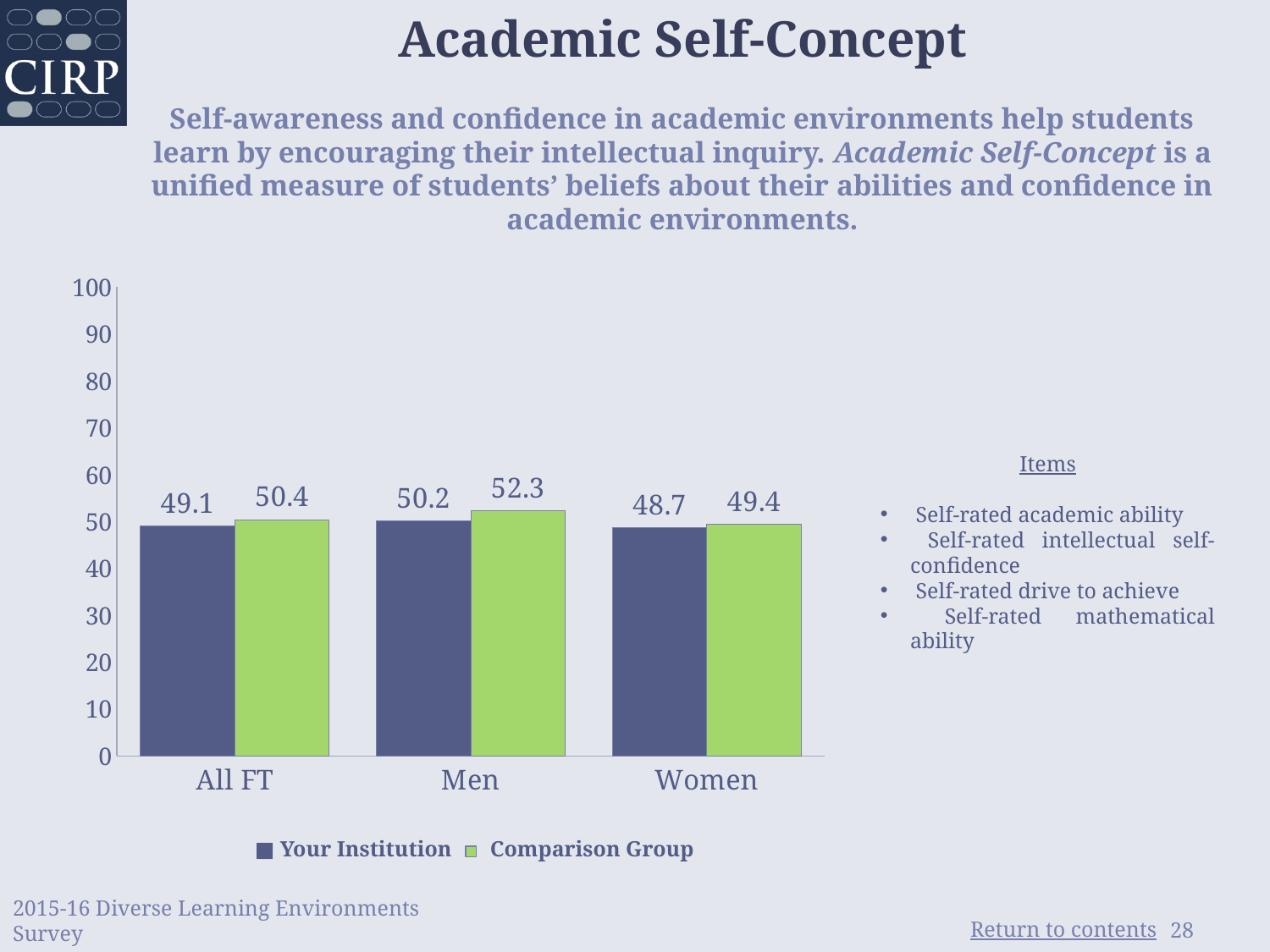
Which is larger for Women: Your Institution or Comparison Group? Comparison Group How many series does the legend list? 2 What is the difference between the Comparison Group and Your Institution values for Men? 2.1 What is the difference between the Comparison Group and Your Institution values for All FT? 1.3 Which category has the lowest Your Institution value? Women Which category has the highest Comparison Group value? Men What is the value for Your Institution in the All FT category? 49.1 Is the value for Your Institution in the Men category greater or less than 60? less What is the value for Your Institution in the Women category? 48.7 How many categories are shown on the x axis? 3 What kind of chart is shown on the slide? bar chart What is the value for Comparison Group in the Men category? 52.3